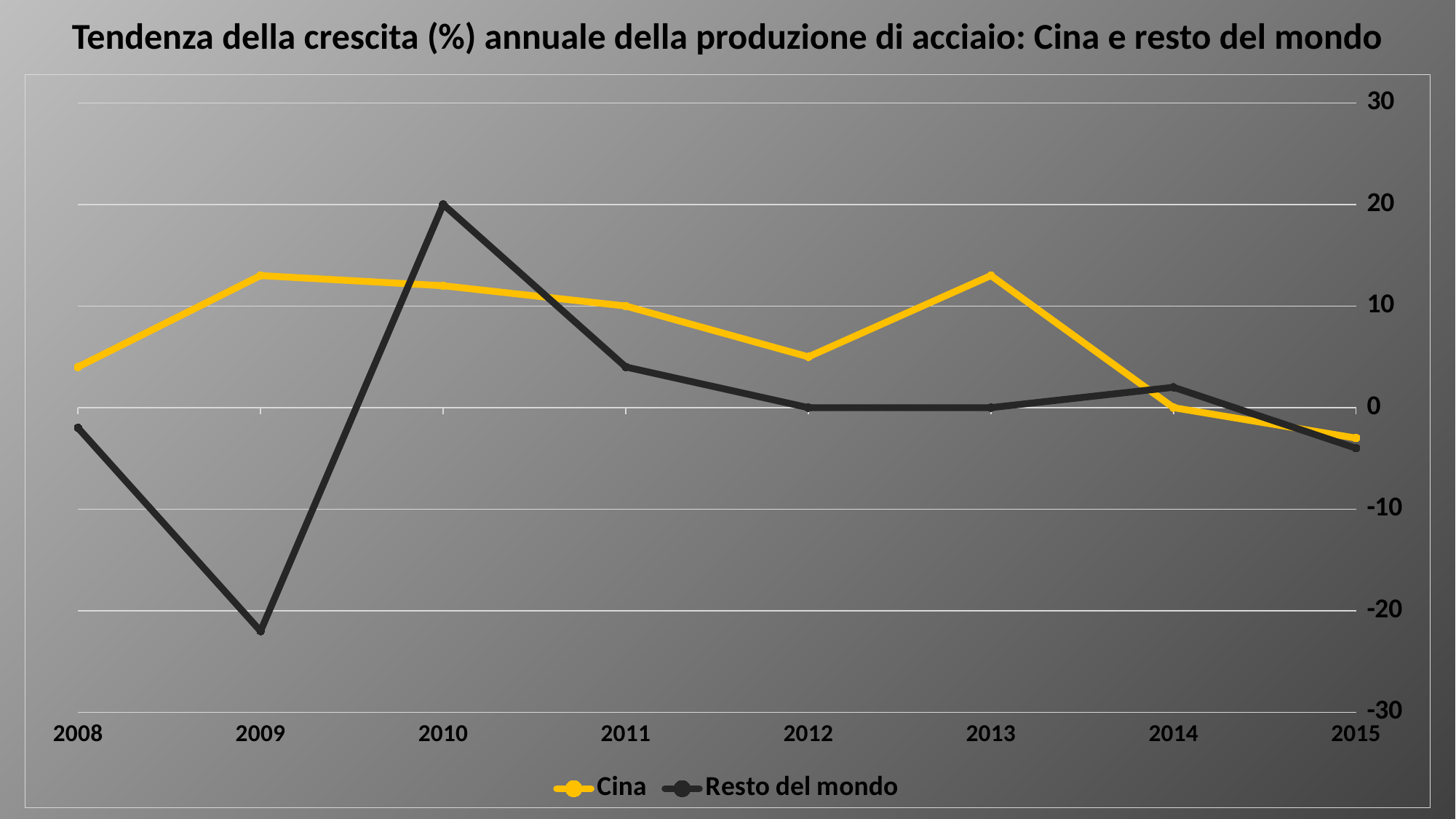
In which year does Resto del mondo reach its lowest value? 2009 Does the Cina line rise or fall from 2013 to 2015? fall In 2010, which series has the larger value, Cina or Resto del mondo? Resto del mondo Is the value for Cina in 2008 greater or less than 10? less Is the value for Resto del mondo in 2009 greater or less than -20? less In which year does Cina reach its lowest value? 2015 What is the value for Resto del mondo in 2010? 20 In 2009, which series has the larger value, Cina or Resto del mondo? Cina What kind of chart is shown on the slide? line chart How many series does the legend list? 2 In which year does Resto del mondo reach its highest value? 2010 How many years are shown on the x axis? 8